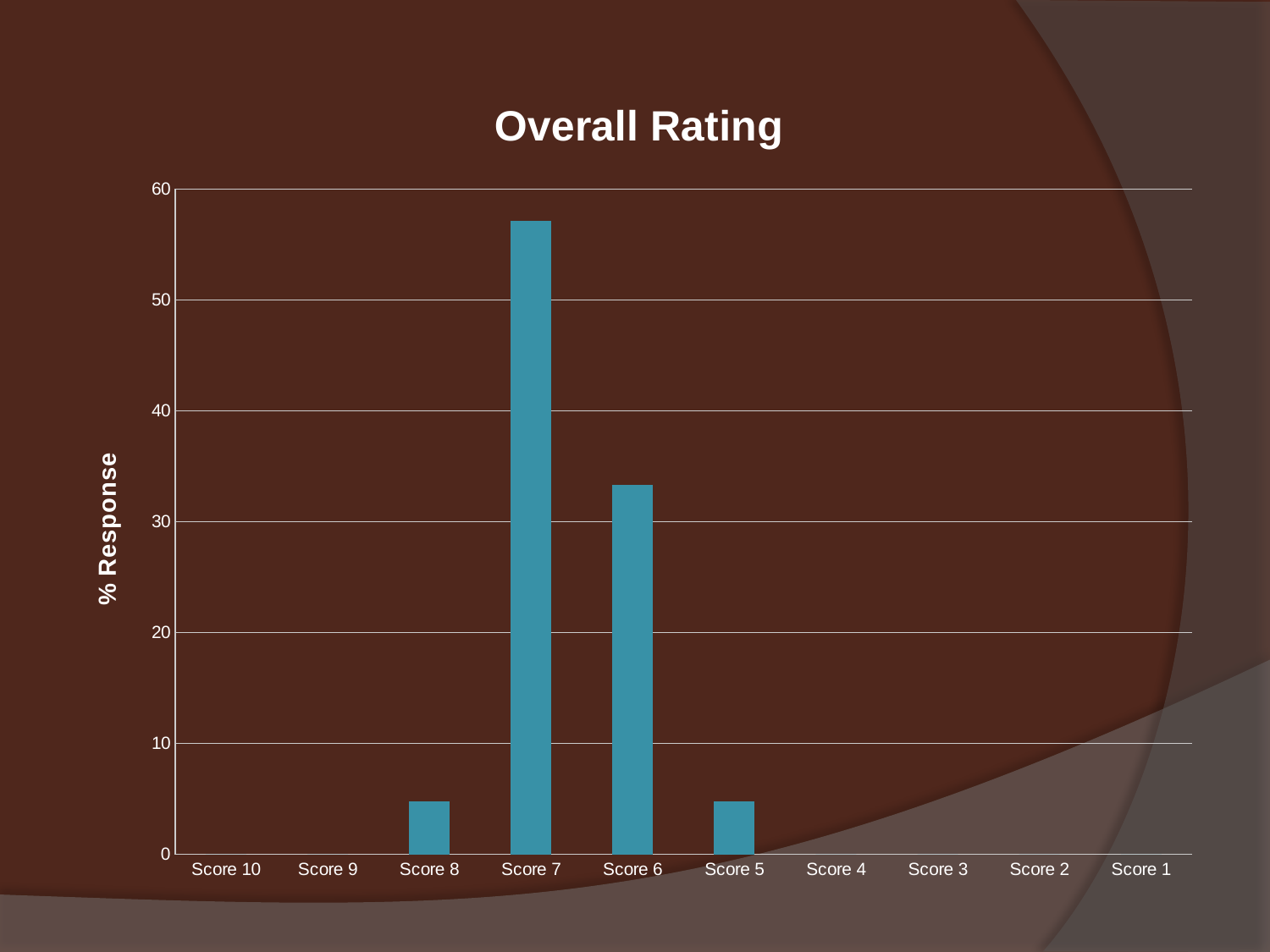
What type of chart is shown on the slide? bar chart Which has a higher % Response, Score 7 or Score 6? Score 7 Is the value for Score 7 greater or less than 50? greater Is the value for Score 8 greater or less than 10? less How many score categories are shown along the x axis? 10 Is the value for Score 6 greater or less than 30? greater What is the label on the vertical axis of the chart? % Response Which has a higher % Response, Score 6 or Score 5? Score 6 Which score category has the highest % Response? Score 7 What is the title of the chart? Overall Rating How many score categories have a visible bar in the chart? 4